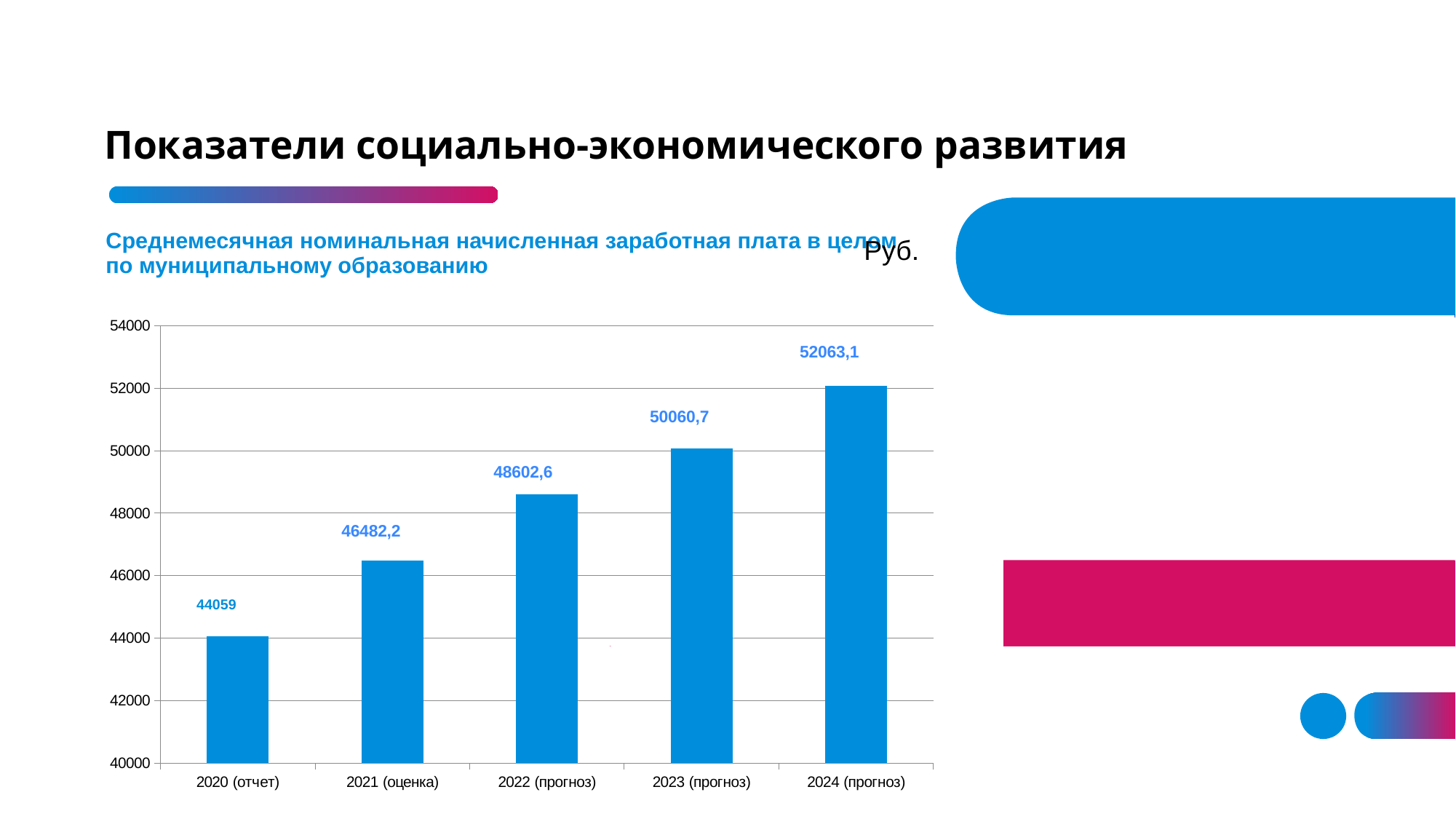
Do the values rise or fall from 2020 (отчет) to 2024 (прогноз)? rise Which category has the lowest value? 2020 (отчет) How many categories are shown on the x axis? 5 Which is larger, the value for 2023 (прогноз) or the value for 2021 (оценка)? 2023 (прогноз) What is the difference between the values for 2024 (прогноз) and 2020 (отчет)? 8004,1 What is the value for 2022 (прогноз)? 48602,6 What is the value for 2020 (отчет)? 44059 Is the value for 2023 (прогноз) greater or less than 48000? greater What is the value for 2024 (прогноз)? 52063,1 Which category has the highest value? 2024 (прогноз) What kind of chart is shown on the slide? bar chart What is the difference between the values for 2021 (оценка) and 2020 (отчет)? 2423,2